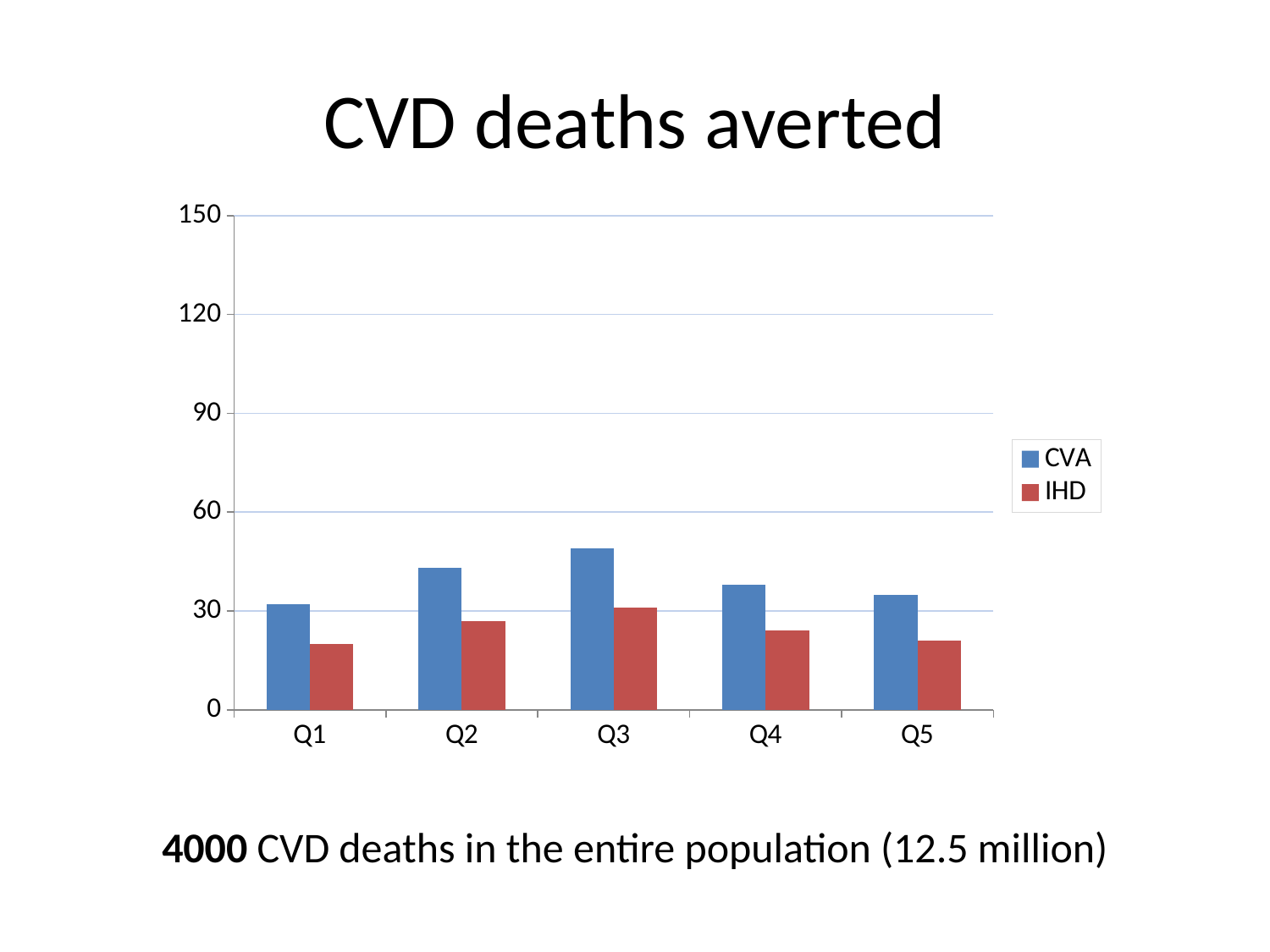
In Q3, which series has the larger value, CVA or IHD? CVA What kind of chart is shown on the slide? bar chart Is the CVA value for Q2 greater or less than 30? greater Which category has the highest CVA value? Q3 Which category has the lowest CVA value? Q1 What is the title of the chart? CVD deaths averted How many categories are shown on the x axis? 5 How many series does the legend list? 2 Which series is shown in blue? CVA Is the CVA value for Q3 greater or less than 60? less Is the IHD value for Q1 greater or less than 30? less Which category has the highest IHD value? Q3